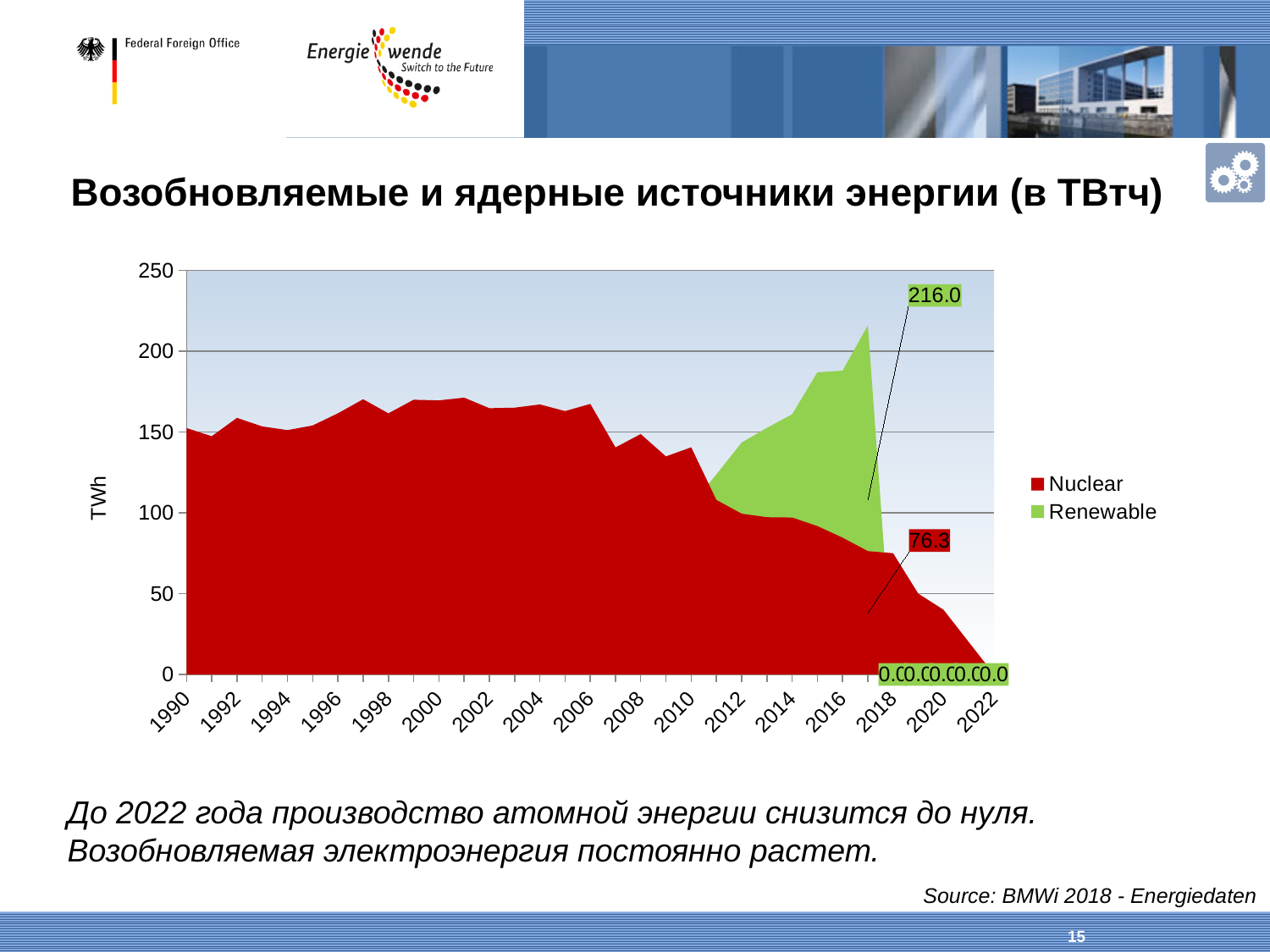
Which labelled value is larger, the Renewable label 216.0 or the Nuclear label 76.3? 216.0 (Renewable) What are the two series named in the chart legend? Nuclear and Renewable What is the data label shown for the Renewable series at its peak? 216.0 Does the Nuclear series rise or fall from 2006 to 2022? fall How many series does the chart legend list? 2 How many year labels are shown on the x axis? 17 What is the data label shown for the Nuclear series near the end of the chart? 76.3 What kind of chart is shown on the slide? area chart Is the Nuclear value in 1990 greater or less than 100? greater What is the label on the vertical axis of the chart? TWh What is the difference between the labelled Renewable value 216.0 and the labelled Nuclear value 76.3? 139.7 Is the Nuclear value in 2020 greater or less than 100? less